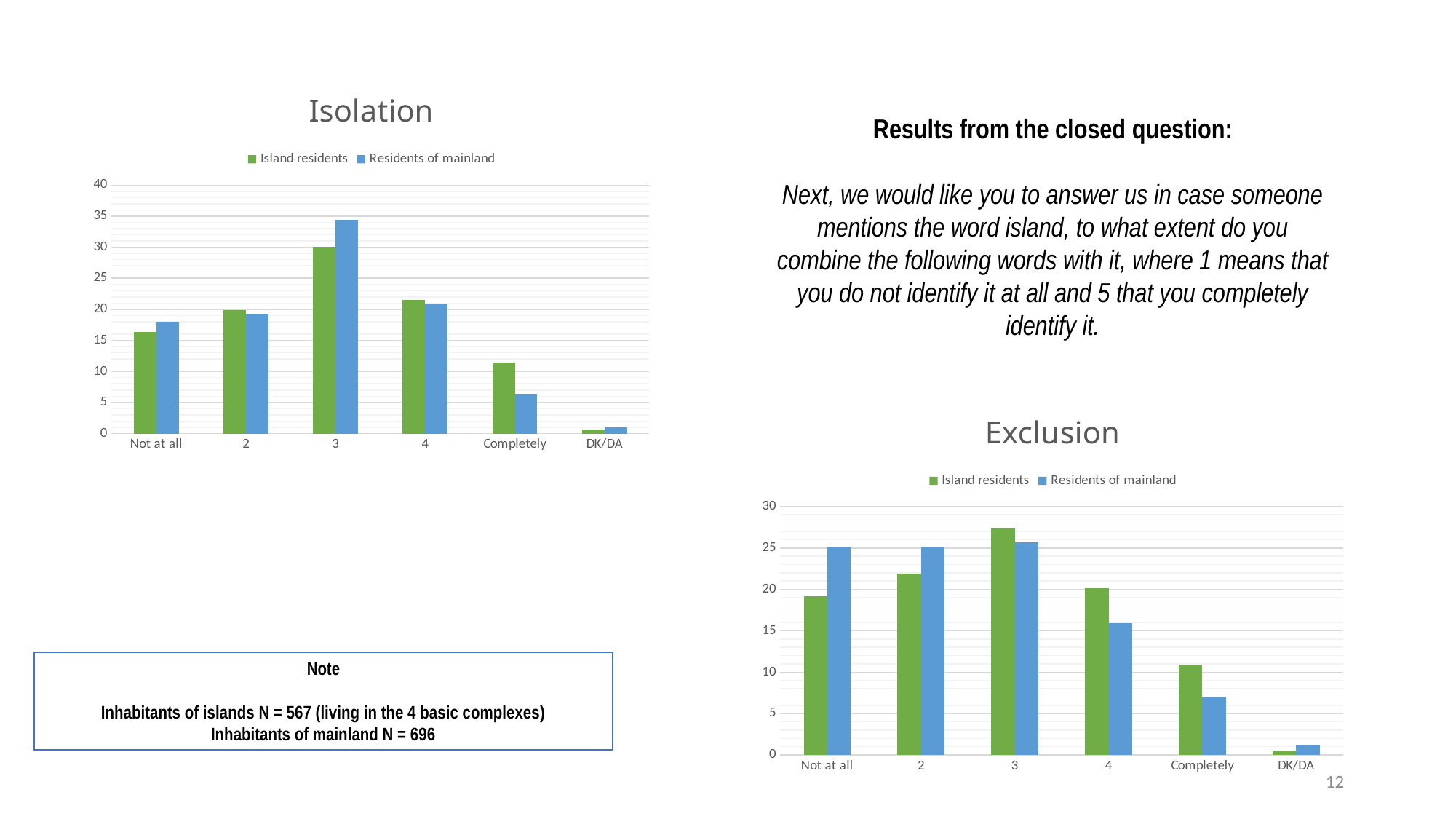
How many series does the legend of the Isolation chart list? 2 In the Isolation chart, which category has the highest value for Residents of mainland? 3 In the Isolation chart, which category has the lowest value for Island residents? DK/DA In the Exclusion chart, which category has the highest value for Island residents? 3 In the Isolation chart, is the value for Residents of mainland at category 3 greater or less than 30? greater In the Exclusion chart, for the Not at all category, which series has the larger value: Island residents or Residents of mainland? Residents of mainland How many categories are shown on the x axis of the Isolation chart? 6 What kind of chart is the Isolation chart? bar chart In the Isolation chart, for the Completely category, which series has the larger value: Island residents or Residents of mainland? Island residents In the Isolation chart, is the value for Island residents at Completely greater or less than 10? greater What are the two legend entries of the Exclusion chart? Island residents and Residents of mainland In the Exclusion chart, is the value for Residents of mainland at category 4 greater or less than 20? less